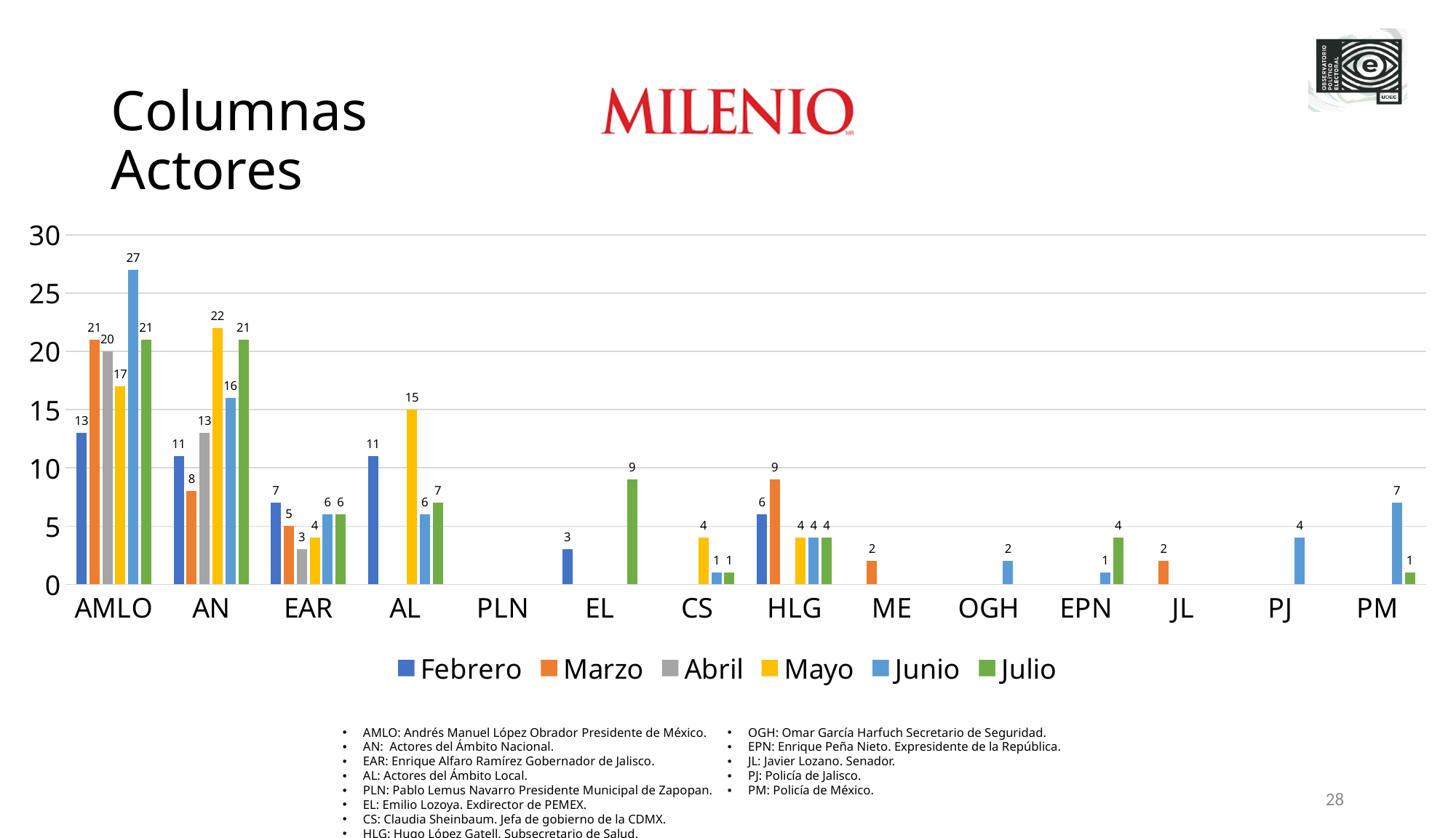
What kind of chart is shown on the slide? Bar chart What is the value for AN in Mayo? 22 Which is larger for AN: the Mayo value or the Junio value? Mayo What is the value for AL in Mayo? 15 What is the value for AMLO in Junio? 27 What is the difference between the Junio and Febrero values for AMLO? 14 What is the value for HLG in Marzo? 9 Which month has the lowest value for EAR? Abril Which month has the highest value for AMLO? Junio How many categories are shown on the x axis? 14 How many series does the legend list? 6 What is the value for PM in Junio? 7